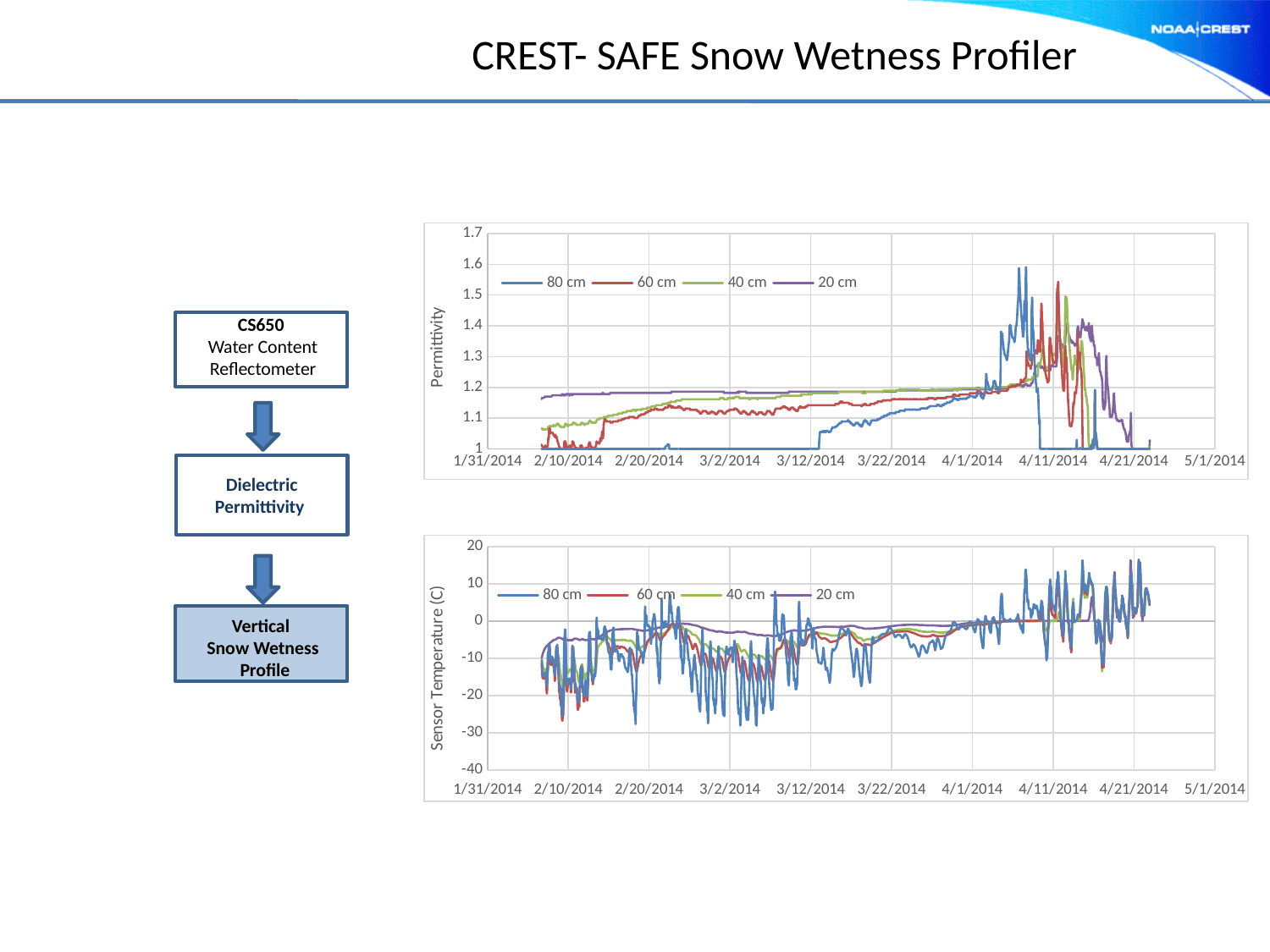
In the top chart (Permittivity), is the value of the 80 cm series at 3/2/2014 greater or less than 1.1? less In the top chart (Permittivity), at 2/20/2014, which series has the larger value: 20 cm or 80 cm? 20 cm In the top chart (Permittivity), what are the four series named in the legend? 80 cm, 60 cm, 40 cm, 20 cm What kind of chart is the top chart (Permittivity)? line chart What kind of chart is the bottom chart (Sensor Temperature)? line chart What is the y-axis label of the bottom chart? Sensor Temperature (C) In the top chart (Permittivity), is the peak value of the 80 cm series near 4/11/2014 greater or less than 1.5? greater In the bottom chart (Sensor Temperature), does the 20 cm series generally rise or fall between 2/10/2014 and 4/11/2014? rise In the top chart (Permittivity), how many series does the legend list? 4 In the top chart (Permittivity), does the 60 cm series generally rise or fall between 2/10/2014 and 4/1/2014? rise In the bottom chart (Sensor Temperature), how many series does the legend list? 4 In the bottom chart (Sensor Temperature), is the lowest value of the 80 cm series around 3/2/2014 greater or less than -20? less